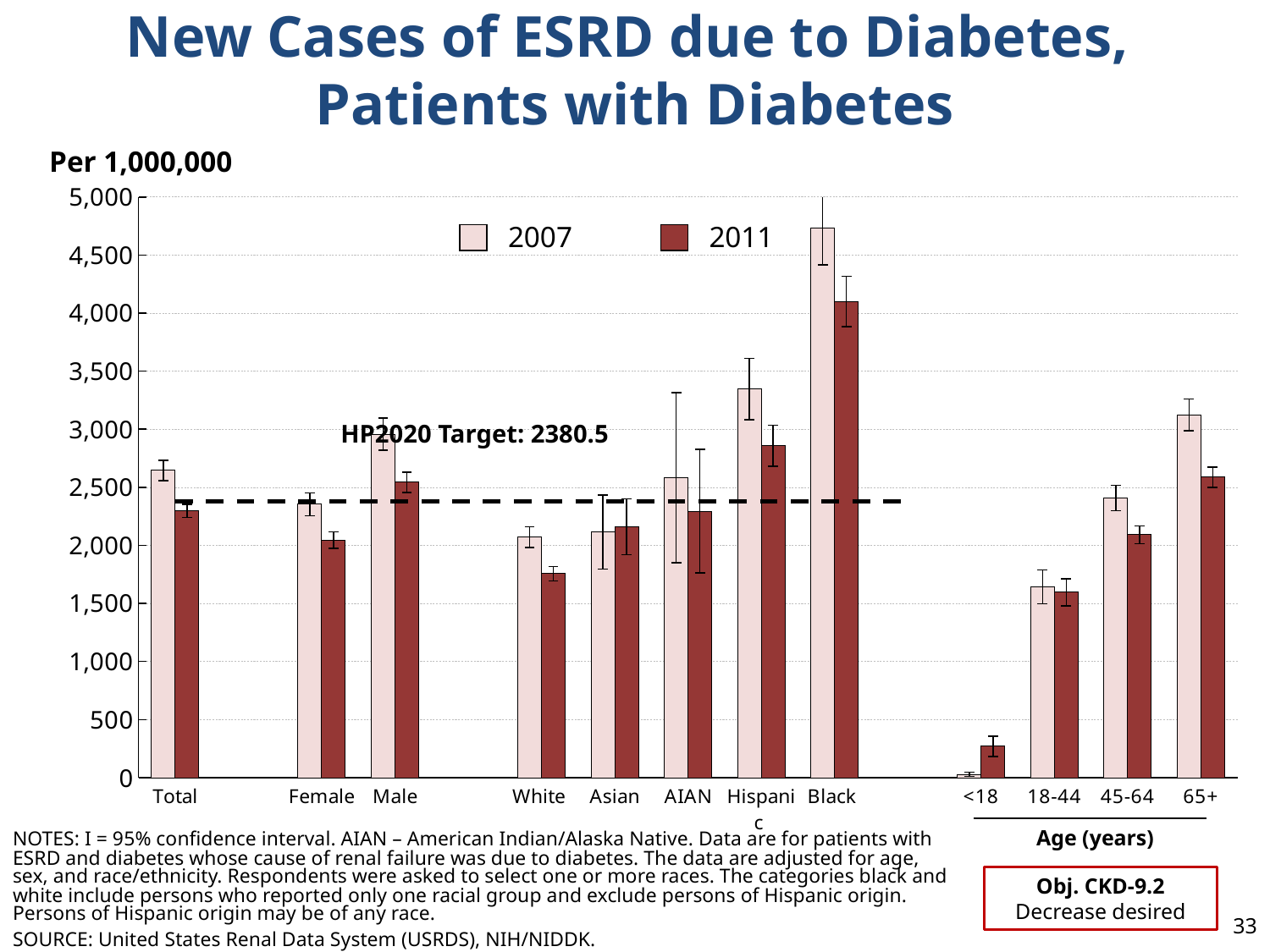
Which category has the highest value for 2007? Black Which category has the lowest value for 2007? <18 For the Total category, which year has the larger value, 2007 or 2011? 2007 Across the age groups from <18 to 65+, do the 2007 values rise or fall? rise What is the HP2020 Target value shown on the chart? 2380.5 How many series does the legend list? 2 Is the 2007 value for 65+ greater or less than 3,000? greater Is the 2007 value for Black greater or less than 4,500? greater What kind of chart is shown on the slide? bar chart Is the 2011 value for <18 greater or less than 500? less How many categories are shown along the x axis? 12